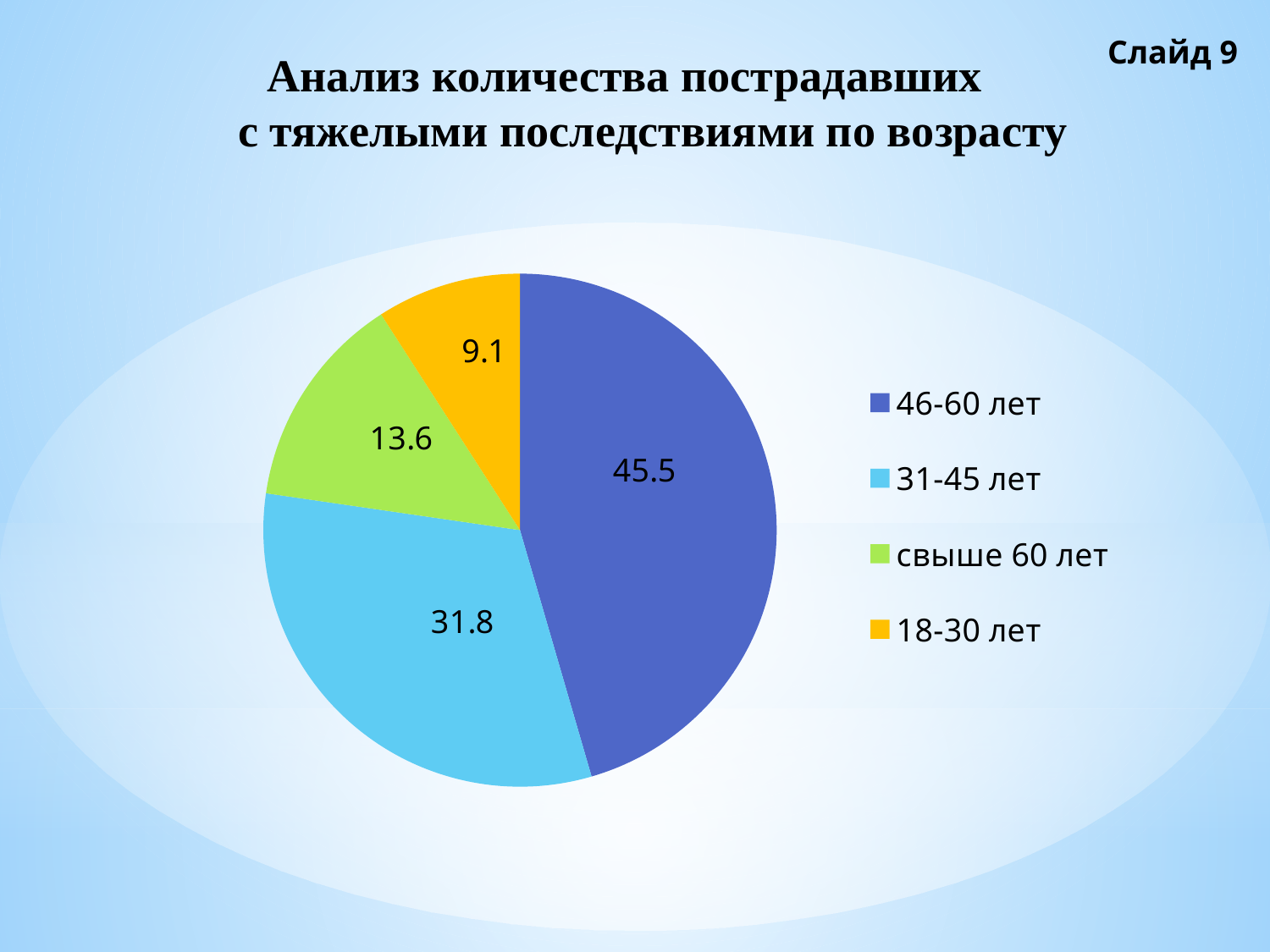
What is the value shown for the свыше 60 лет slice? 13.6 What is the value shown for the 31-45 лет slice? 31.8 What is the value shown for the 46-60 лет slice? 45.5 Which is larger, the value for 31-45 лет or the value for свыше 60 лет? 31-45 лет What is the difference between the values for свыше 60 лет and 18-30 лет? 4.5 Which age group has the smallest slice of the pie? 18-30 лет What is the value shown for the 18-30 лет slice? 9.1 What kind of chart is shown on the slide? Pie chart What colour is the slice for 18-30 лет? Orange How many age groups are shown in the pie chart? 4 Which age group has the largest slice of the pie? 46-60 лет What is the difference between the values for 46-60 лет and 31-45 лет? 13.7